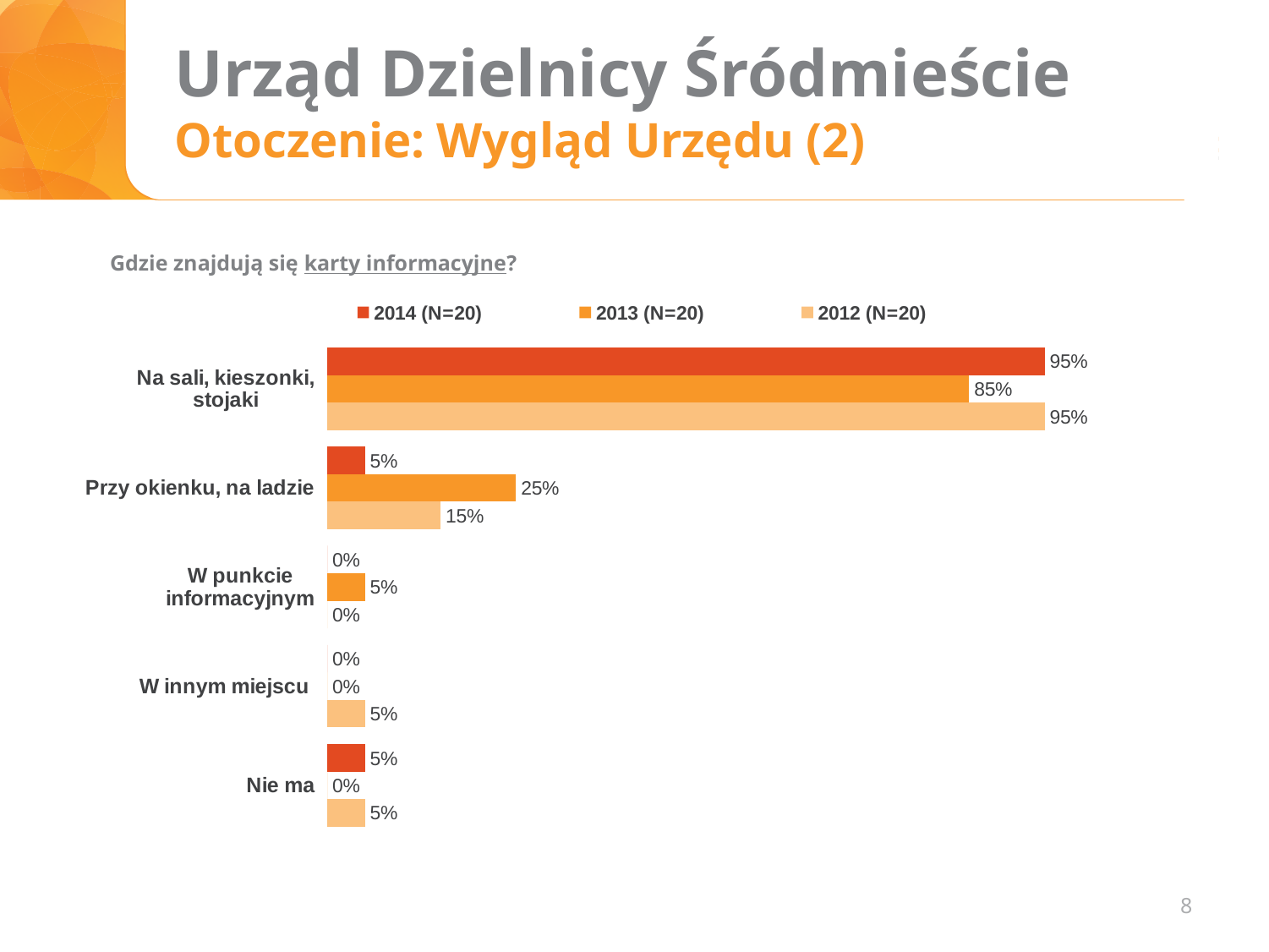
What is the difference between the 2014 (N=20) and 2013 (N=20) values for "Na sali, kieszonki, stojaki"? 10% How many series does the legend list? 3 What kind of chart is shown on the slide? Bar chart What is the value for "Przy okienku, na ladzie" in the 2012 (N=20) series? 15% What is the difference between the 2013 (N=20) and 2012 (N=20) values for "Przy okienku, na ladzie"? 10% How many categories are shown on the chart? 5 What is the value for "W punkcie informacyjnym" in the 2013 (N=20) series? 5% Which category has the highest value in the 2013 (N=20) series? Na sali, kieszonki, stojaki What is the value for "Na sali, kieszonki, stojaki" in the 2014 (N=20) series? 95% What is the value for "Przy okienku, na ladzie" in the 2013 (N=20) series? 25% What question is the chart answering, as written above it? Gdzie znajdują się karty informacyjne? Which is larger for "Przy okienku, na ladzie": the 2014 (N=20) value or the 2013 (N=20) value? 2013 (N=20)